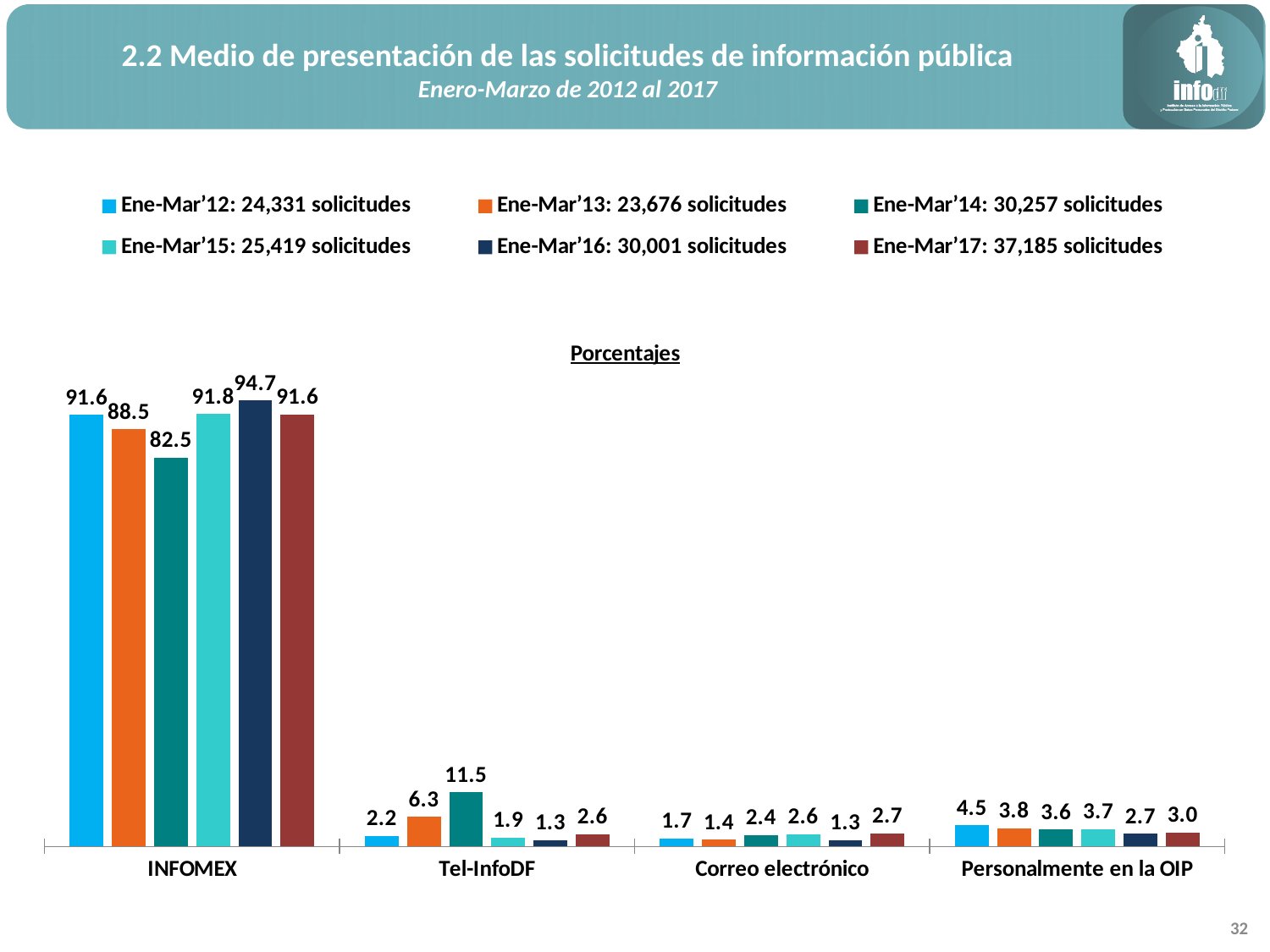
What is the value for INFOMEX in the Ene-Mar'16 series? 94.7 Which is larger for Personalmente en la OIP: the Ene-Mar'12 value or the Ene-Mar'16 value? Ene-Mar'12 What is the value for Personalmente en la OIP in the Ene-Mar'12 series? 4.5 According to the legend, how many solicitudes were there in Ene-Mar'17? 37,185 What is the value for Tel-InfoDF in the Ene-Mar'14 series? 11.5 What is the difference between the Ene-Mar'14 and Ene-Mar'13 values for Tel-InfoDF? 5.2 How many categories are shown on the x axis? 4 Which series has the highest value for INFOMEX? Ene-Mar'16 What kind of chart is shown on the slide? Bar chart What is the value for Correo electrónico in the Ene-Mar'17 series? 2.7 How many series does the legend list? 6 Which series has the lowest value for INFOMEX? Ene-Mar'14